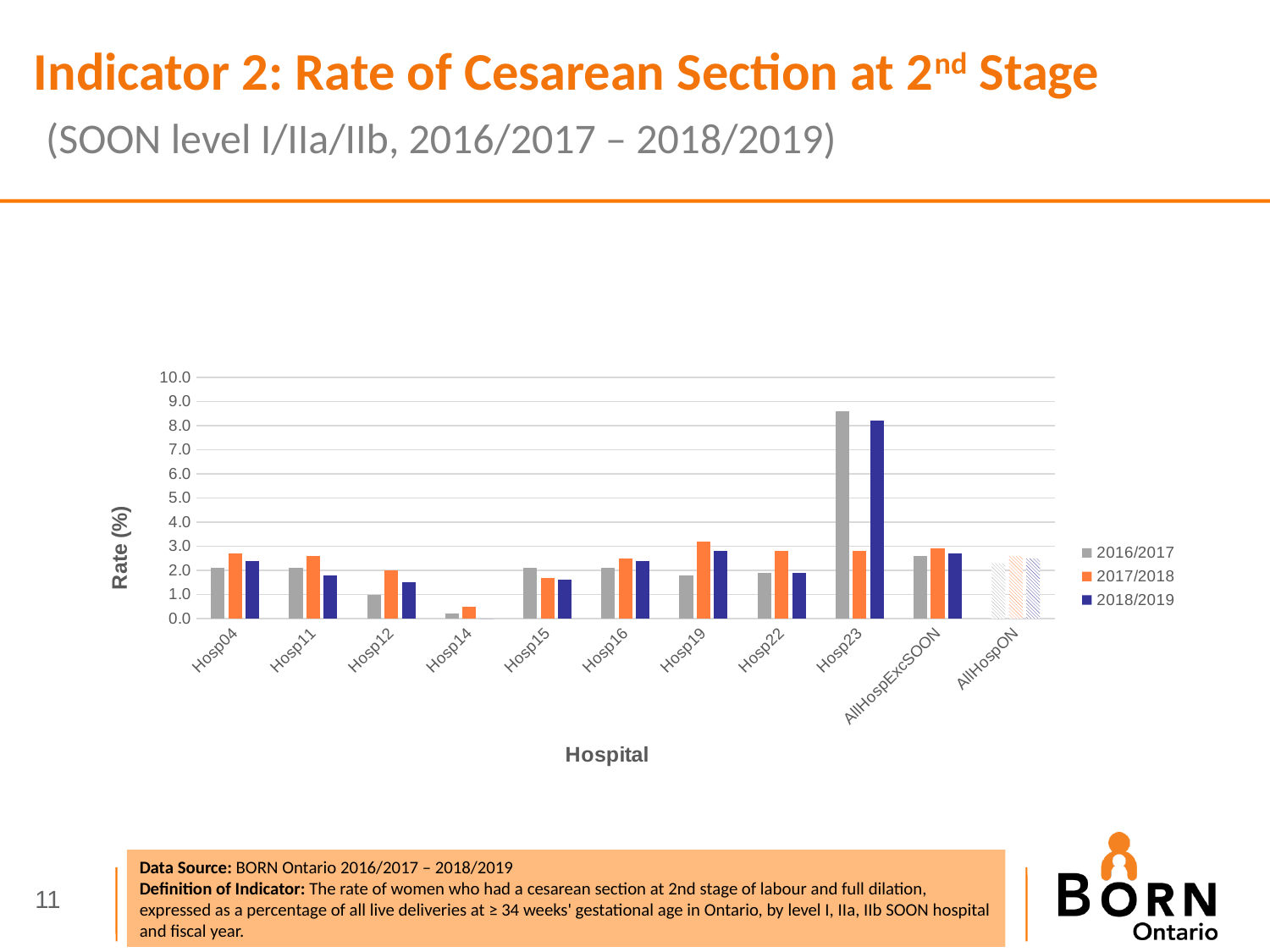
Is the 2017/2018 value for Hosp04 greater or less than 2.0? greater Which hospital has the lowest 2017/2018 rate? Hosp14 For Hosp12, which is larger: the 2016/2017 value or the 2017/2018 value? 2017/2018 For Hosp23, which is larger: the 2016/2017 value or the 2017/2018 value? 2016/2017 How many hospital categories are shown on the x axis? 11 What kind of chart is shown on the slide? Bar chart What is the title of the y axis? Rate (%) Is the 2016/2017 value for Hosp23 greater or less than 8.0? greater How many series does the legend list? 3 Which hospital has the highest 2016/2017 rate? Hosp23 Is the 2017/2018 value for Hosp14 greater or less than 1.0? less